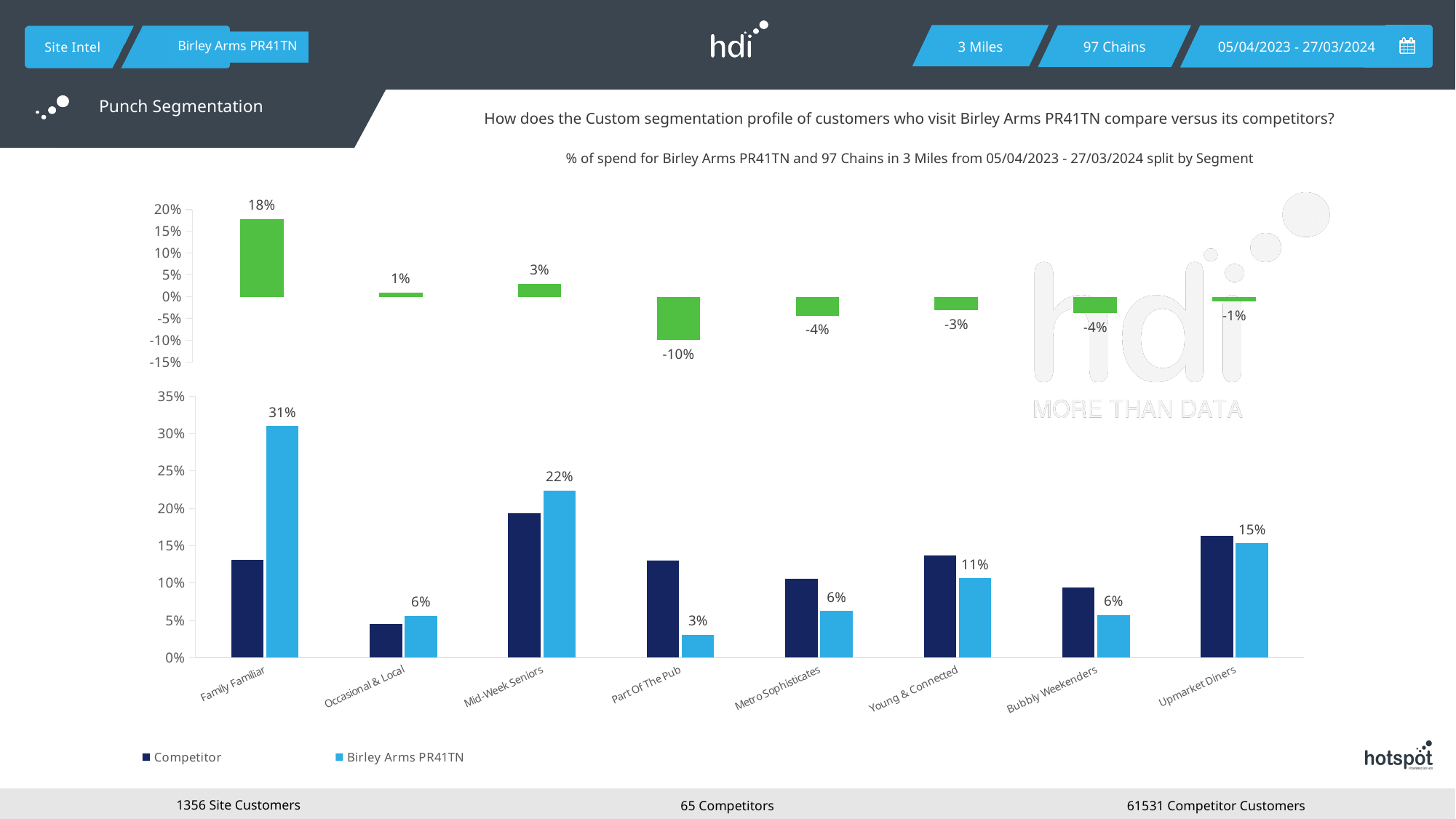
In the bottom chart, which segment has the highest Birley Arms PR41TN value? Family Familiar In the bottom chart, is the Competitor value for Family Familiar greater or less than 15%? less How many segments are shown on the x axis of the bottom chart? 8 In the bottom chart, what is the value for Birley Arms PR41TN in the Young & Connected segment? 11% In the bottom chart, for Part Of The Pub, which is larger: the Competitor value or the Birley Arms PR41TN value? Competitor In the bottom chart, what is the value for Birley Arms PR41TN in the Family Familiar segment? 31% In the top chart, which segment has the highest value? Family Familiar In the top chart, which segment has the lowest value? Part Of The Pub In the bottom chart, is the Competitor value for Mid-Week Seniors greater or less than 15%? greater How many series does the legend of the bottom chart list? 2 In the top chart, what is the value shown for Part Of The Pub? -10% In the bottom chart, what is the difference between the Birley Arms PR41TN values for Family Familiar and Mid-Week Seniors? 9 percentage points